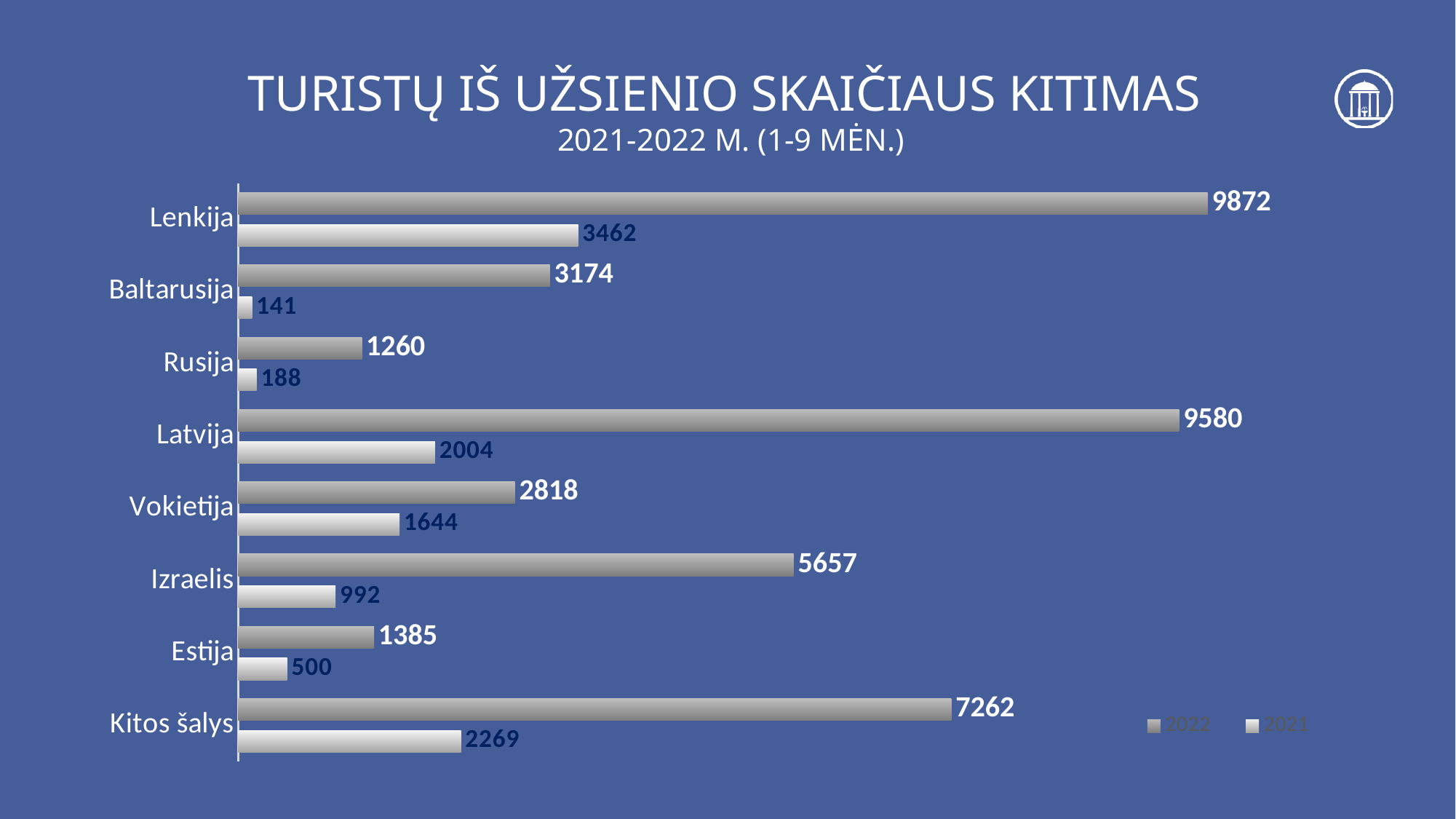
Which category has the highest 2022 value? Lenkija What is the 2021 value for Baltarusija? 141 What is the title of the chart? TURISTŲ IŠ UŽSIENIO SKAIČIAUS KITIMAS 2021-2022 M. (1-9 MĖN.) How many series does the legend list? 2 What is the difference between the 2022 and 2021 values for Izraelis? 4665 What is the 2021 value for Latvija? 2004 How many categories are shown on the chart? 8 What kind of chart is shown on the slide? Bar chart What is the 2022 value for Kitos šalys? 7262 Which category has the lowest 2021 value? Baltarusija What is the 2022 value for Lenkija? 9872 Which is larger: the 2022 value for Vokietija or the 2022 value for Baltarusija? Baltarusija